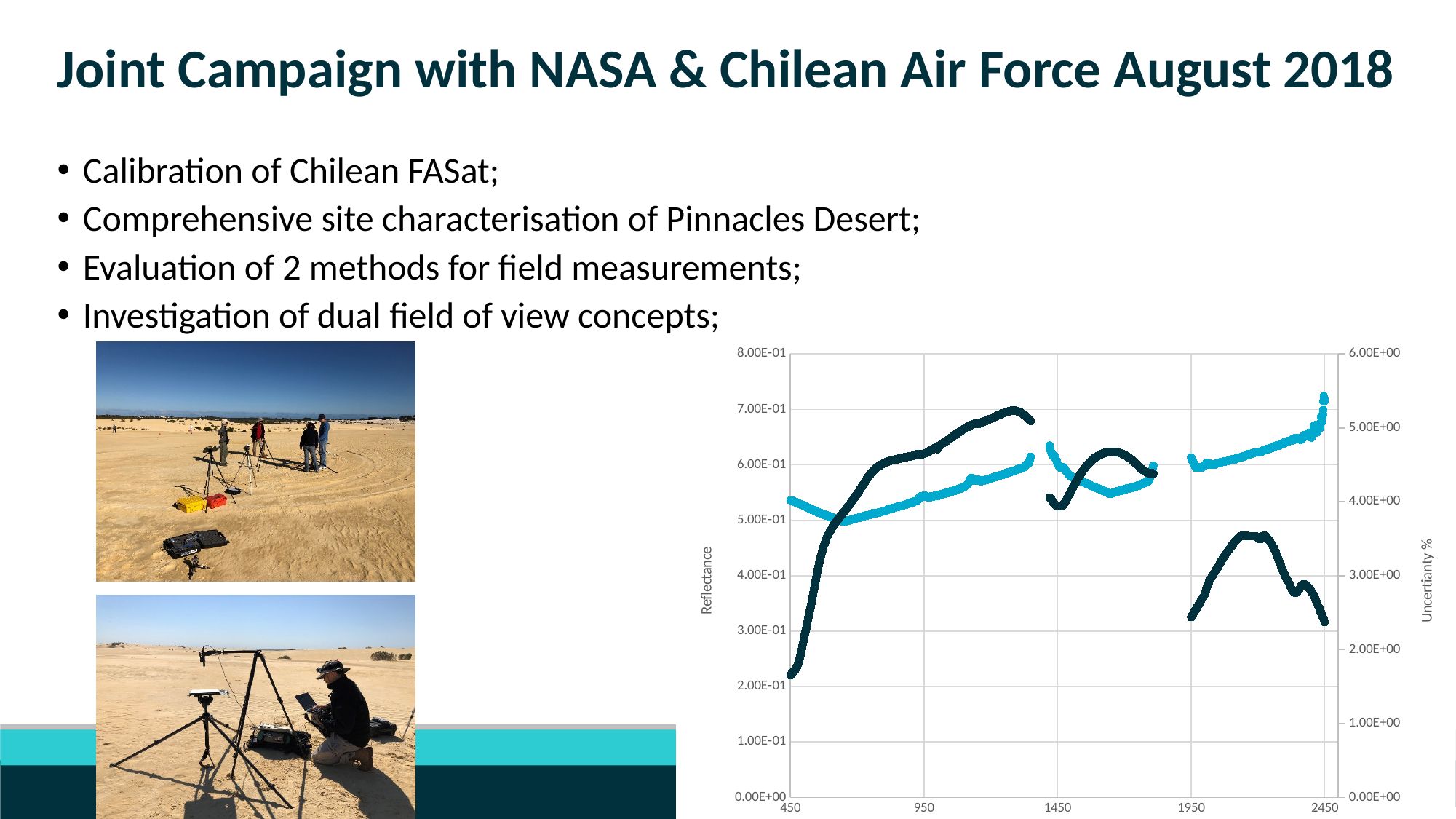
What is the label of the left vertical axis of the chart? Reflectance What kind of chart is shown on the right of the slide? scatter chart Does the light blue series rise or fall between x = 1950 and x = 2450? rise Is the value of the light blue series at x = 2450 greater or less than 6.00E-01 on the left axis? greater What is the label of the right vertical axis of the chart? Uncertianty % Is the value of the dark series at x = 2450 greater or less than 4.00E-01 on the left axis? less How many data series are plotted in the chart? 2 How many tick labels are shown on the x axis of the chart? 5 Is the value of the light blue series at x = 450 greater or less than 5.00E-01 on the left axis? greater Does the dark series rise or fall between x = 450 and x = 950? rise